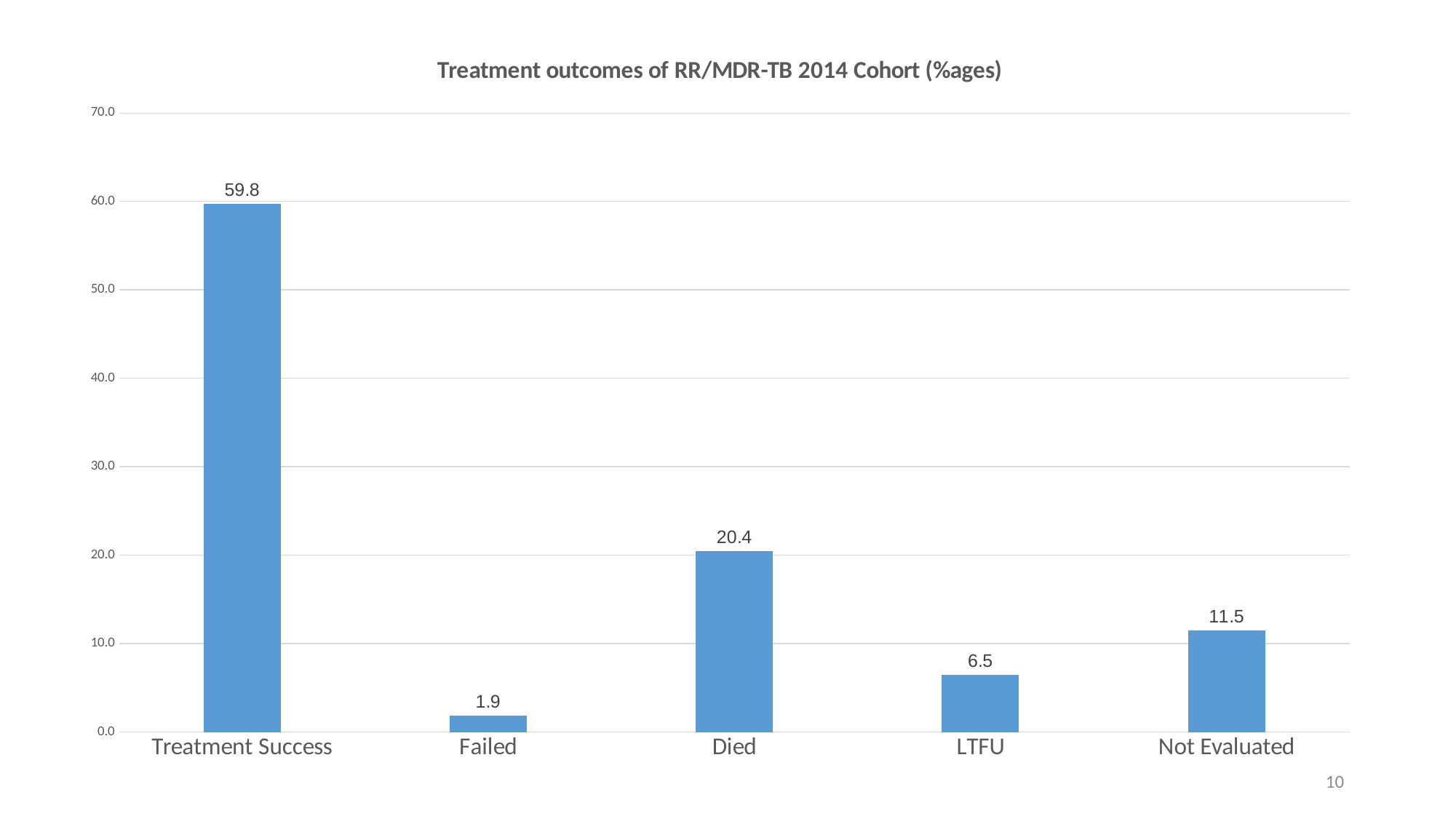
What is the difference between the values for Treatment Success and Died? 39.4 What is the value for Treatment Success? 59.8 What is the value for LTFU? 6.5 What is the difference between the values for Not Evaluated and LTFU? 5.0 What is the value for Not Evaluated? 11.5 What kind of chart is shown on the slide? Bar chart Which category has the highest value? Treatment Success Which is larger, the value for Died or the value for Not Evaluated? Died Is the value for Died greater or less than 30.0? less Which category has the lowest value? Failed How many categories are shown on the x axis? 5 What is the value for Died? 20.4